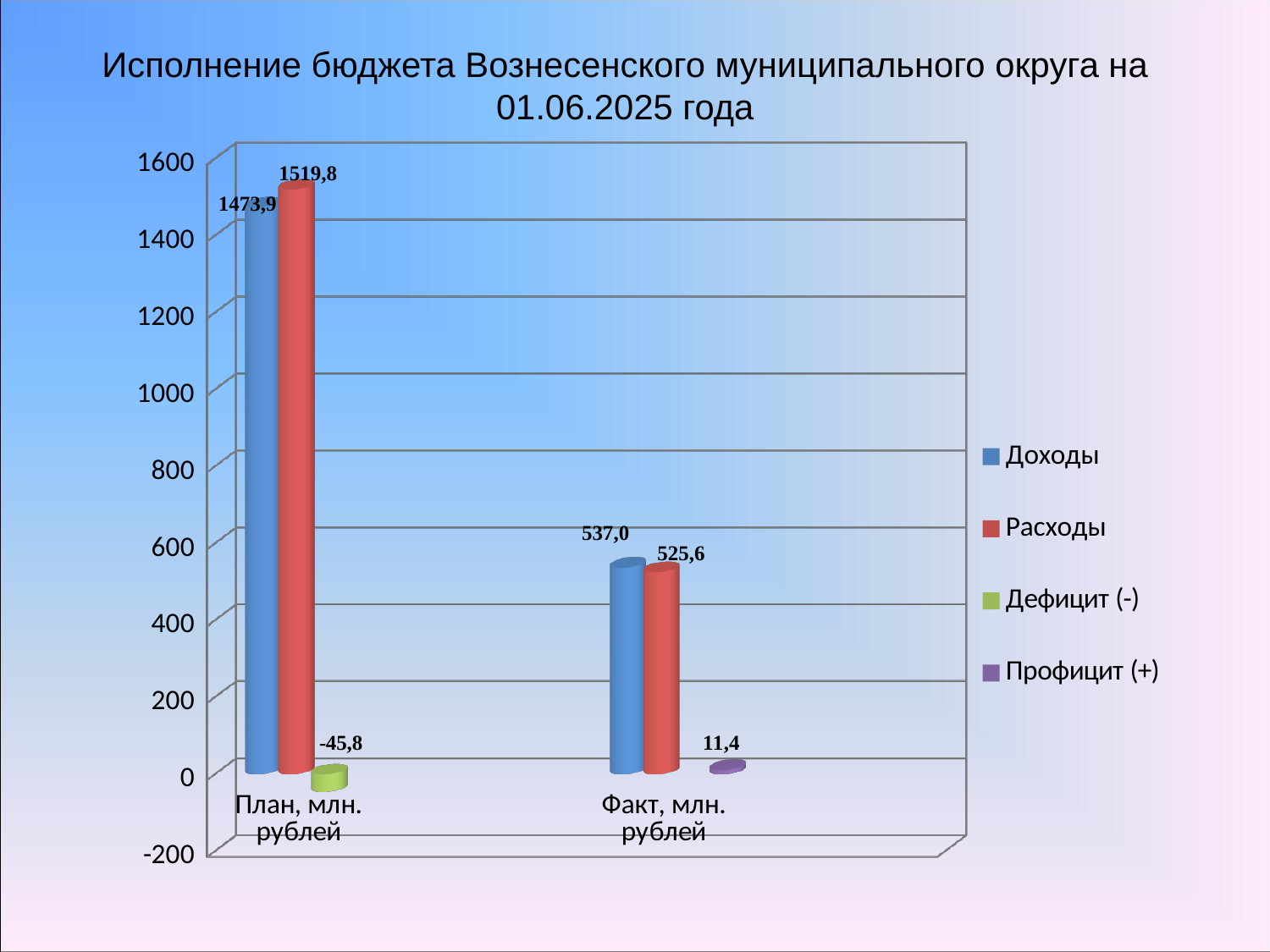
How many series does the legend list? 4 What is the value of Расходы for План, млн. рублей? 1519,8 What is the title of the chart? Исполнение бюджета Вознесенского муниципального округа на 01.06.2025 года What is the value of Доходы for План, млн. рублей? 1473,9 What is the value of Доходы for Факт, млн. рублей? 537,0 What is the difference between Расходы and Доходы for План, млн. рублей? 45,9 What is the difference between Доходы and Расходы for Факт, млн. рублей? 11,4 What is the value of Профицит (+) for Факт, млн. рублей? 11,4 What kind of chart is shown on the slide? Bar chart What is the value of Дефицит (-) for План, млн. рублей? -45,8 Which is larger for План, млн. рублей: Доходы or Расходы? Расходы What is the value of Расходы for Факт, млн. рублей? 525,6